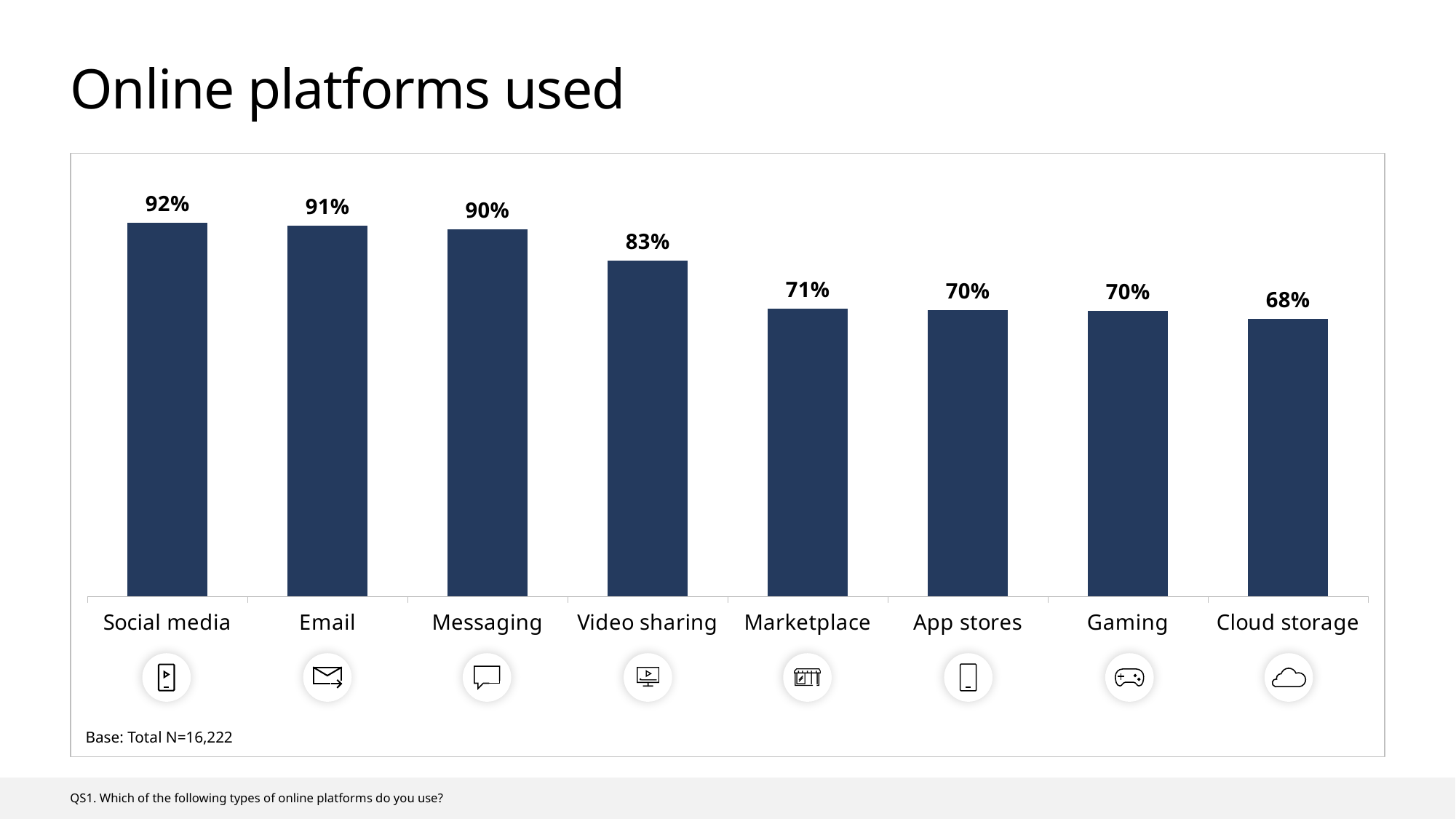
What is the difference in percentage points between Social media and Cloud storage? 24 What is the base sample size stated below the chart? Total N=16,222 What is the value shown for Video sharing? 83% What percentage of respondents use social media? 92% What type of chart is shown on the slide? Bar chart Do the values rise or fall moving from left to right across the chart? Fall Which online platform has the lowest usage percentage? Cloud storage What is the difference in percentage points between Messaging and Video sharing? 7 How many platform categories are shown in the chart? 8 What percentage is shown for Cloud storage? 68% Which online platform has the highest usage percentage? Social media Which has a higher value, Video sharing or Marketplace? Video sharing